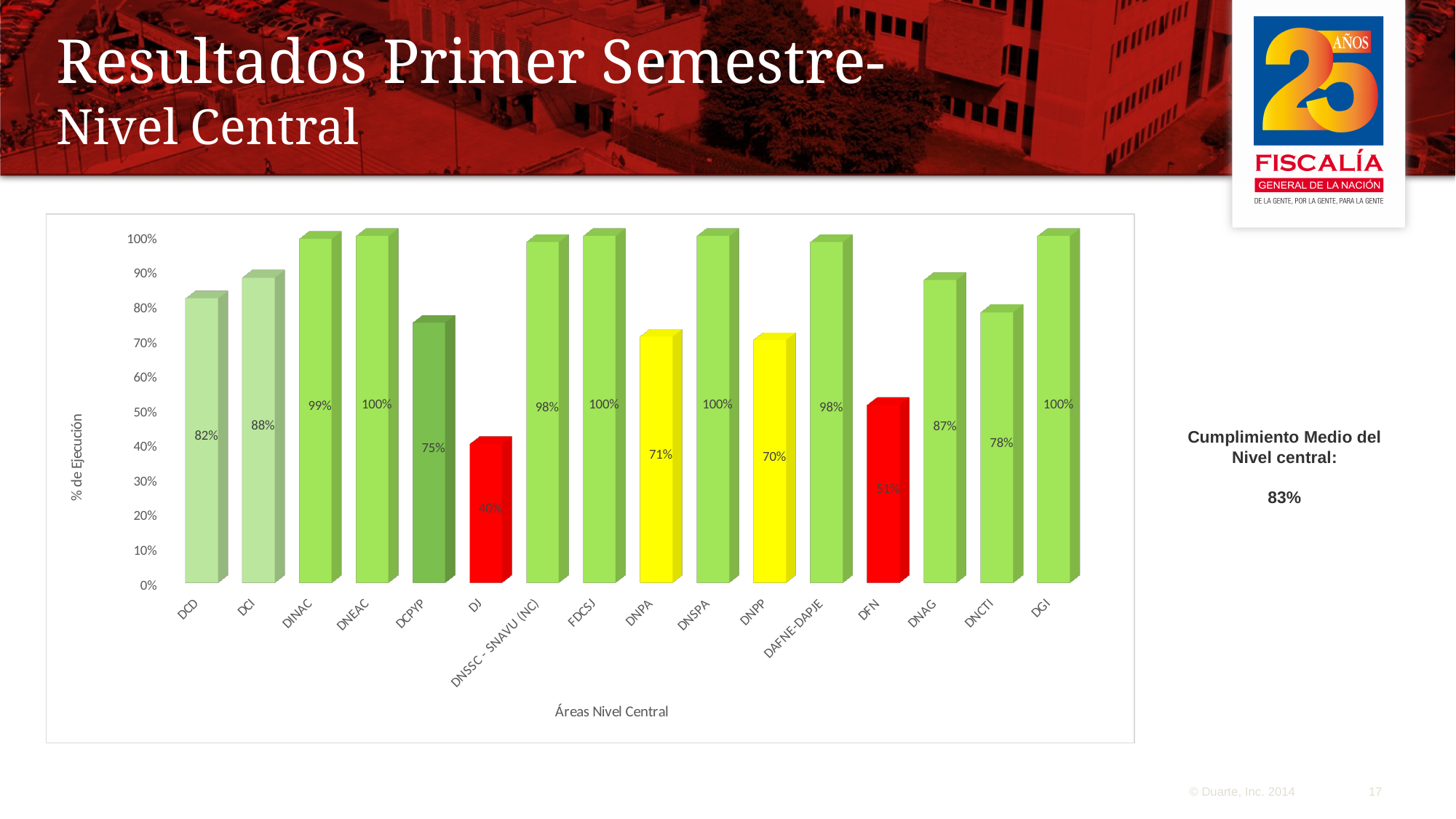
What is the value for DJ? 40% What is the value for DFN? 51% Which category has the lowest value? DJ How many categories are shown on the x axis? 16 Which is larger, the value for DNPA or the value for DNPP? DNPA What is the value for DNCTI? 78% What is the difference between the values for DCI and DCD? 6% What is the value for DCPYP? 75% What is the title of the vertical axis? % de Ejecución Is the value for DNAG greater or less than 80%? greater What kind of chart is shown on the slide? bar chart What is the value for DNSSC - SNAVU (NC)? 98%